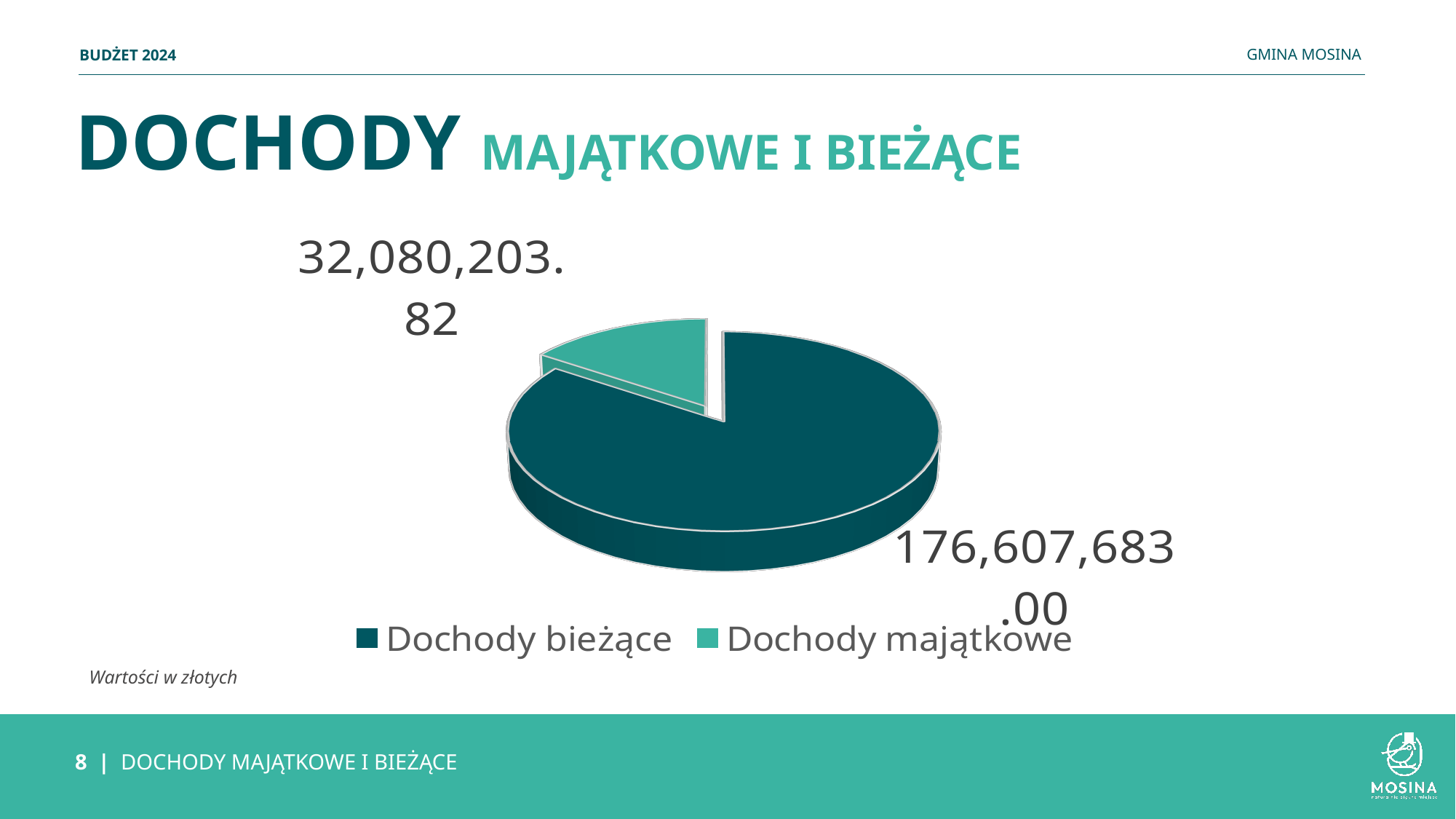
What is the value for Dochody bieżące? 176,607,683.00 What is the difference between the values for Dochody bieżące and Dochody majątkowe? 144,527,479.18 Which category has the largest slice of the pie? Dochody bieżące What is the value for Dochody majątkowe? 32,080,203.82 What is the title of the slide containing the chart? DOCHODY MAJĄTKOWE I BIEŻĄCE How many entries does the legend list? 2 Which is larger, Dochody bieżące or Dochody majątkowe? Dochody bieżące What type of chart is shown on the slide? Pie chart What is the total of the two values shown in the pie chart? 208,687,886.82 Which category has the smallest slice of the pie? Dochody majątkowe How many slices does the pie chart have? 2 In what unit are the chart values expressed, according to the note on the slide? Złotych (Wartości w złotych)